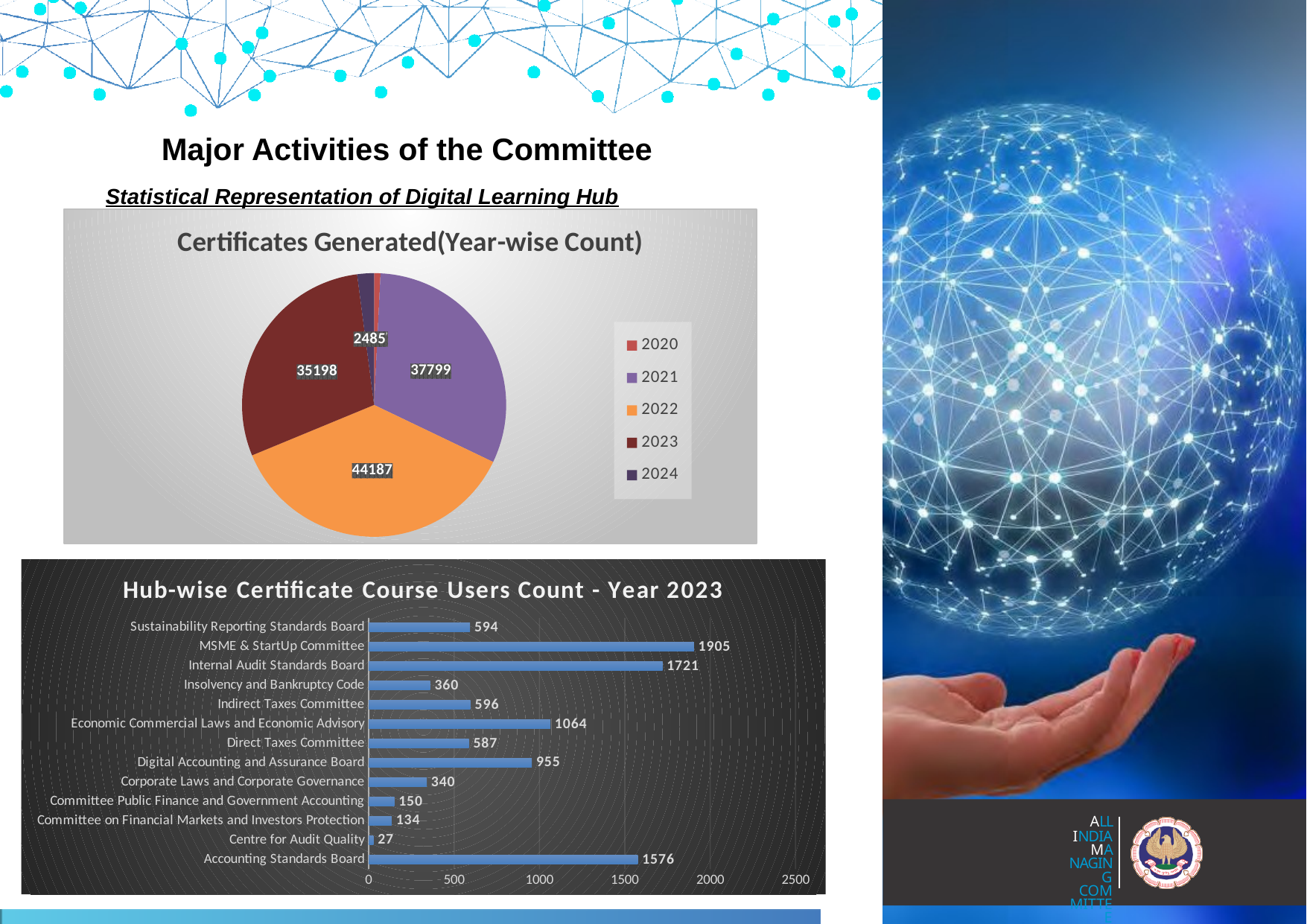
In the 'Certificates Generated(Year-wise Count)' pie chart, what is the value for 2023? 35198 How many years does the legend of the 'Certificates Generated(Year-wise Count)' chart list? 5 In the 'Certificates Generated(Year-wise Count)' pie chart, what is the value for 2021? 37799 In the 'Hub-wise Certificate Course Users Count - Year 2023' chart, which hub has the highest users count? MSME & StartUp Committee In the 'Certificates Generated(Year-wise Count)' pie chart, which year has the largest slice? 2022 How many hubs are shown in the 'Hub-wise Certificate Course Users Count - Year 2023' chart? 13 In the 'Hub-wise Certificate Course Users Count - Year 2023' chart, what is the value for MSME & StartUp Committee? 1905 In the 'Hub-wise Certificate Course Users Count - Year 2023' chart, which hub has the lowest users count? Centre for Audit Quality In the 'Certificates Generated(Year-wise Count)' pie chart, how many certificates were generated in 2022? 44187 What kind of chart is 'Certificates Generated(Year-wise Count)'? Pie chart In the 'Hub-wise Certificate Course Users Count - Year 2023' chart, what is the difference between Internal Audit Standards Board and Accounting Standards Board? 145 In the 'Hub-wise Certificate Course Users Count - Year 2023' chart, which is larger: Digital Accounting and Assurance Board or Economic Commercial Laws and Economic Advisory? Economic Commercial Laws and Economic Advisory